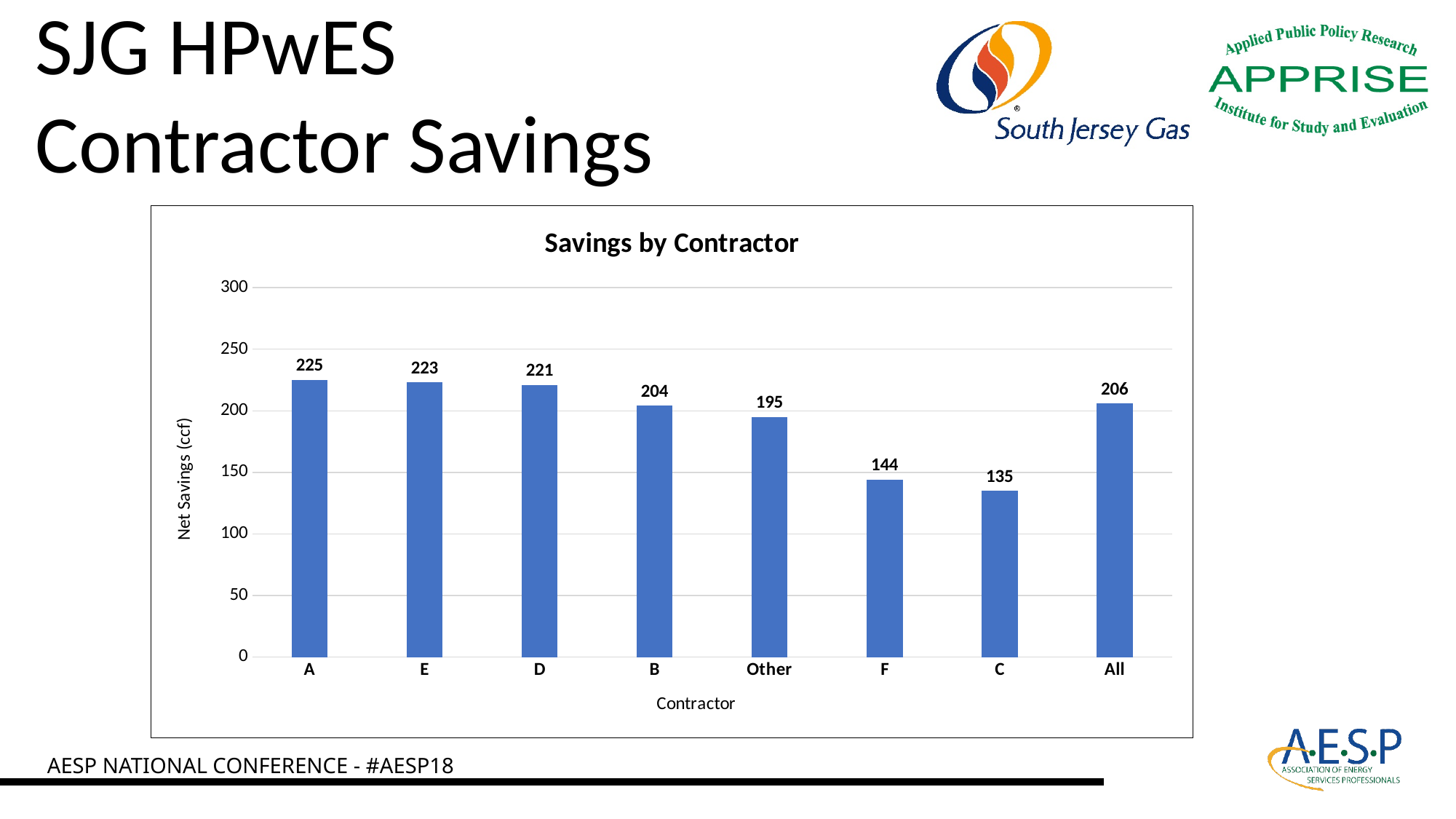
Which has higher net savings, contractor D or contractor B? D What is the net savings value for contractor A? 225 Is the value for contractor C greater or less than 150? less What is the title of the chart? Savings by Contractor What is the net savings value shown for the 'All' category? 206 What kind of chart is shown on the slide? bar chart What is the net savings value for contractor F? 144 What is the difference in net savings between contractor B and the 'Other' category? 9 Which contractor has the highest net savings? A What is the difference in net savings between contractor A and contractor C? 90 How many categories are shown on the x axis of the chart? 8 Which contractor has the lowest net savings? C